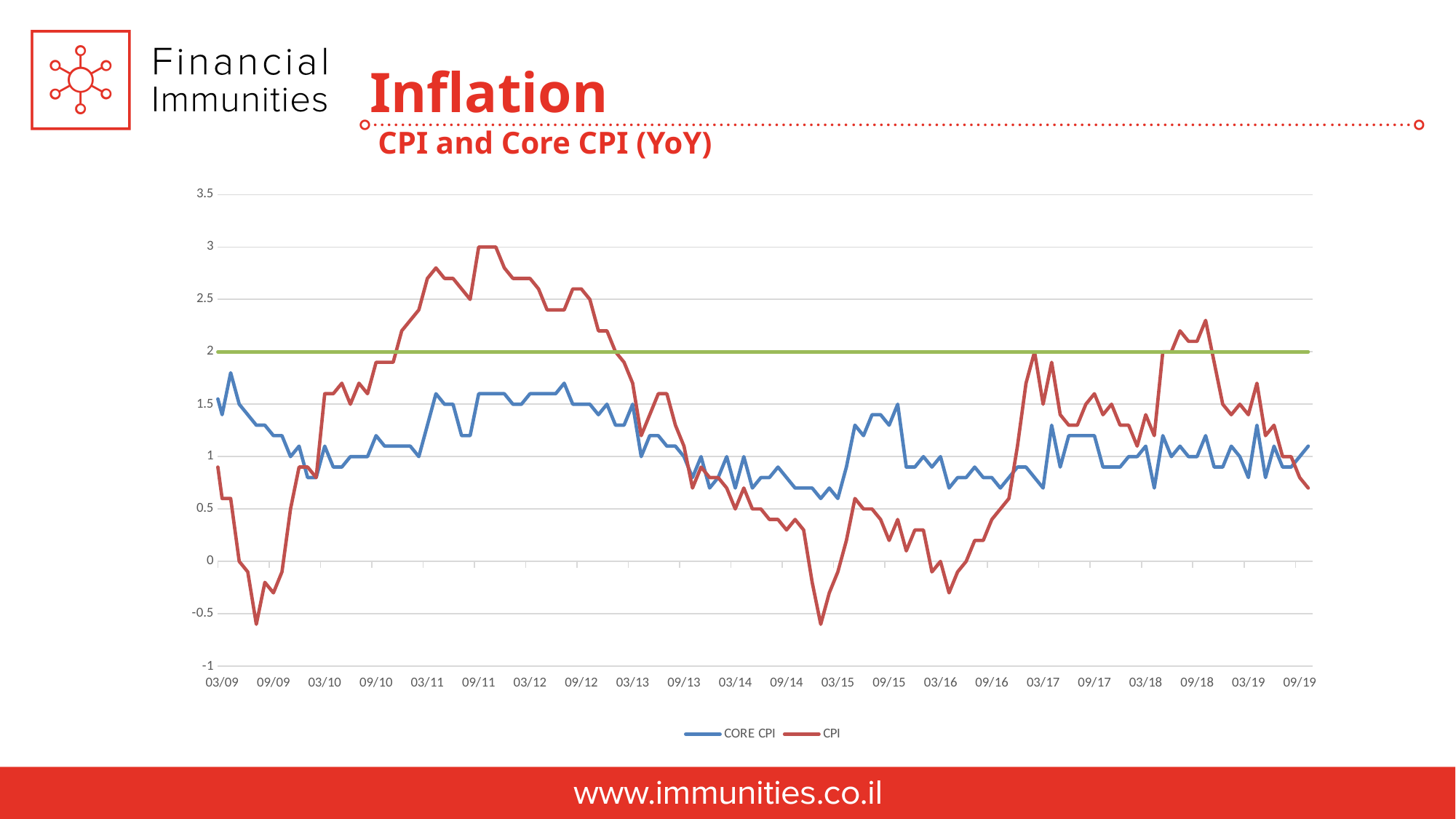
At what level is the green horizontal line drawn on the chart? 2 Is the value of CPI at 09/19 greater or less than 1? less Does CPI rise or fall overall between 09/11 and 09/14? fall At 09/11, which series is higher, CPI or CORE CPI? CPI How many series does the legend list? 2 What are the two series named in the legend? CORE CPI and CPI Which series reaches the highest value anywhere on the chart? CPI Is the value of CPI at 09/11 greater or less than 2.5? greater Is the value of CORE CPI at 03/09 greater or less than 1? greater At 03/15, which series is higher, CPI or CORE CPI? CORE CPI What kind of chart is shown on the slide? line chart